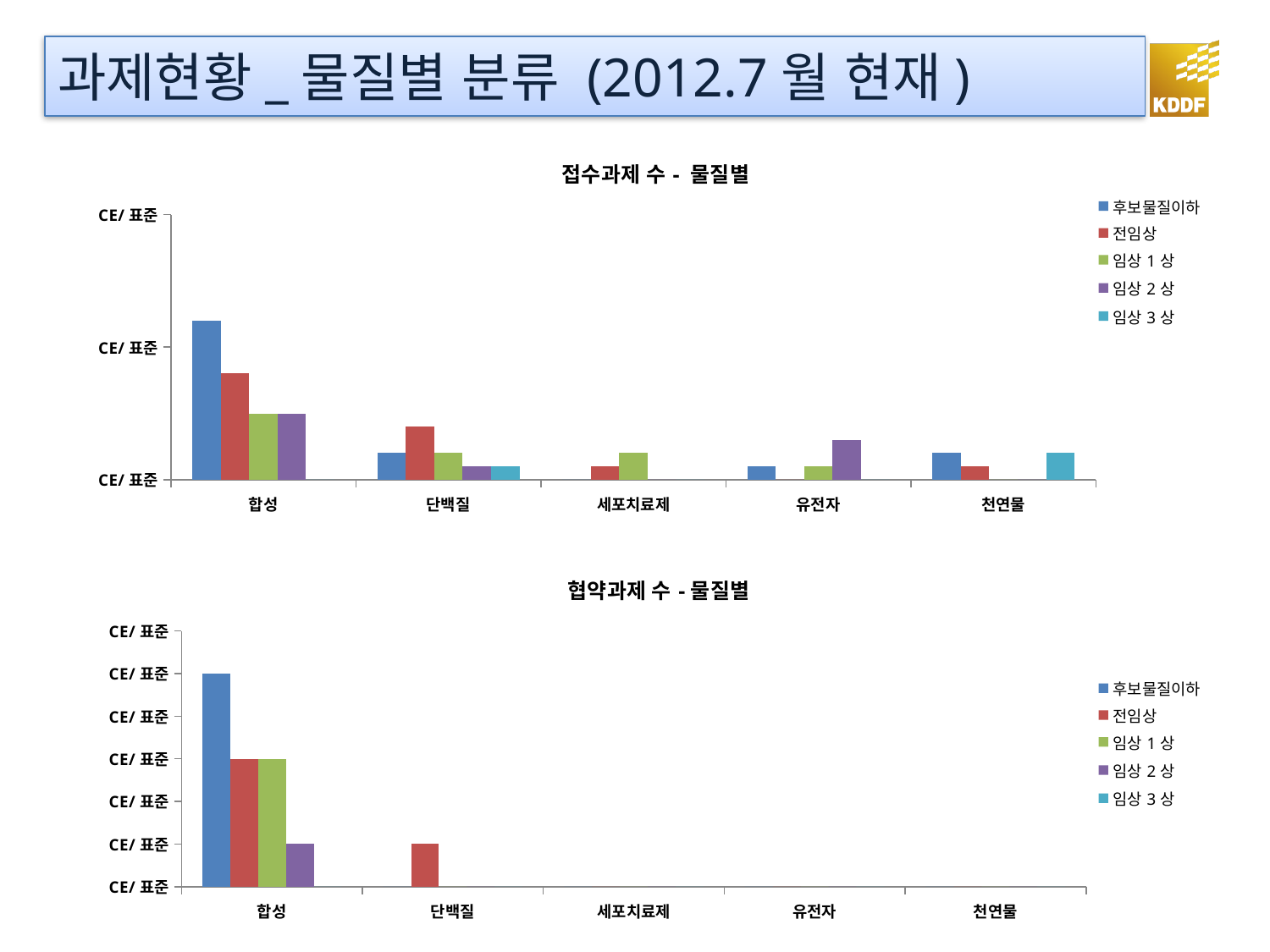
In the top chart (접수과제 수 - 물질별), which is larger for 합성: 후보물질이하 or 전임상? 후보물질이하 What kind of chart is the top chart titled 접수과제 수 - 물질별? Bar chart In the top chart (접수과제 수 - 물질별), which series has the highest value for 합성? 후보물질이하 In the top chart (접수과제 수 - 물질별), which category has the tallest bar overall? 합성 In the top chart (접수과제 수 - 물질별), which series has the highest value for 단백질? 전임상 In the bottom chart (협약과제 수 - 물질별), which is the only series with a bar for 단백질? 전임상 What kind of chart is the bottom chart titled 협약과제 수 - 물질별? Bar chart In the bottom chart (협약과제 수 - 물질별), how many series does the legend list? 5 In the top chart (접수과제 수 - 물질별), how many categories are shown on the x axis? 5 In the bottom chart (협약과제 수 - 물질별), which series has the lowest non-zero value for 합성? 임상 2 상